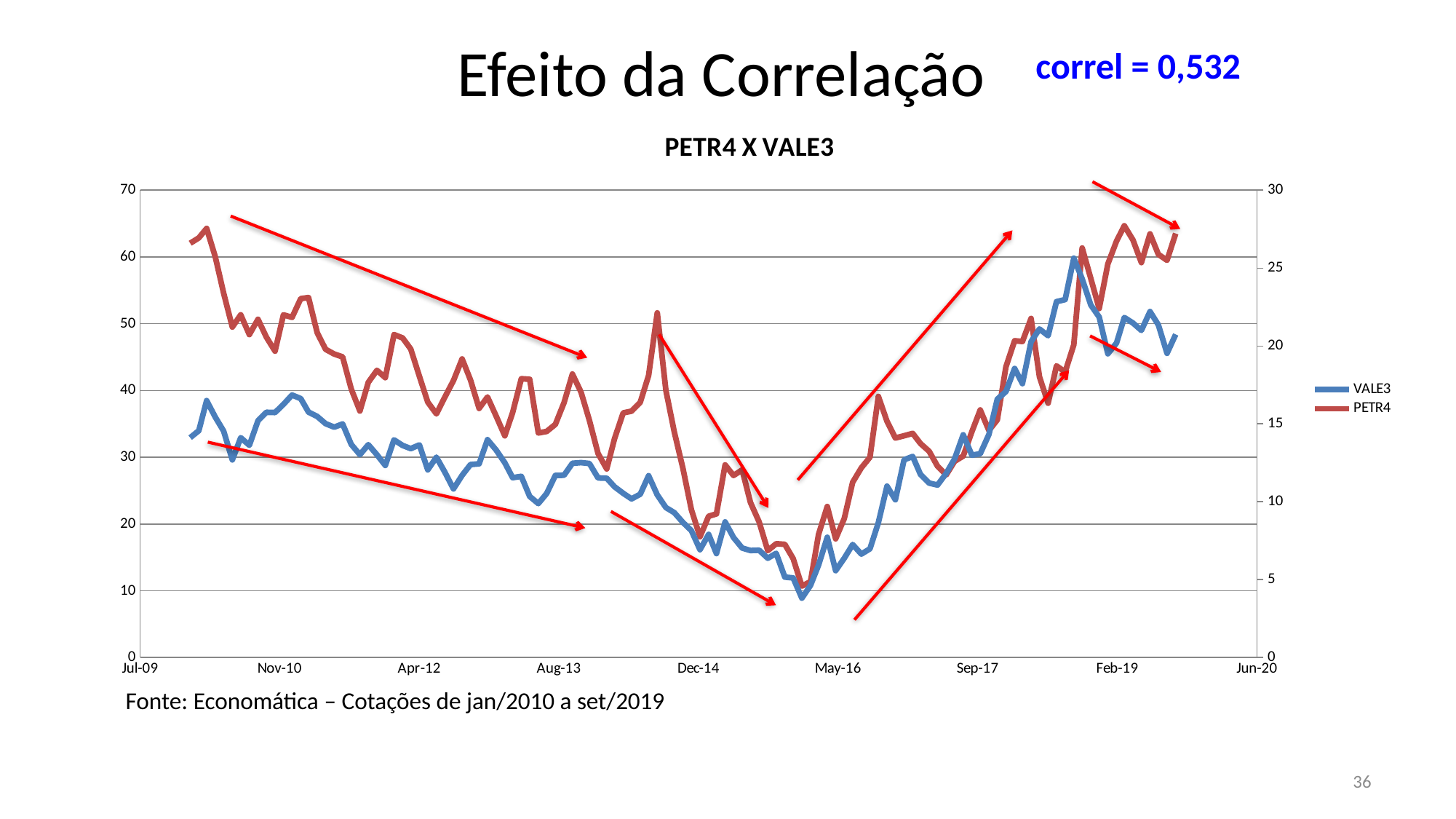
Is the first plotted value of the PETR4 series (right axis) greater or less than 25? greater Does the VALE3 series rise or fall between Jul-09 and Dec-14? fall Is the lowest value of the PETR4 series (right axis) greater or less than 10? less Is the highest value of the VALE3 series (left axis) greater or less than 50? greater Does the VALE3 series rise or fall between May-16 and Feb-19? rise How many series does the legend list? 2 Which colour is used for the VALE3 series? blue What correlation value is printed on the slide? correl = 0,532 What kind of chart is shown on the slide? line chart Does the PETR4 series rise or fall between Nov-10 and Aug-13? fall